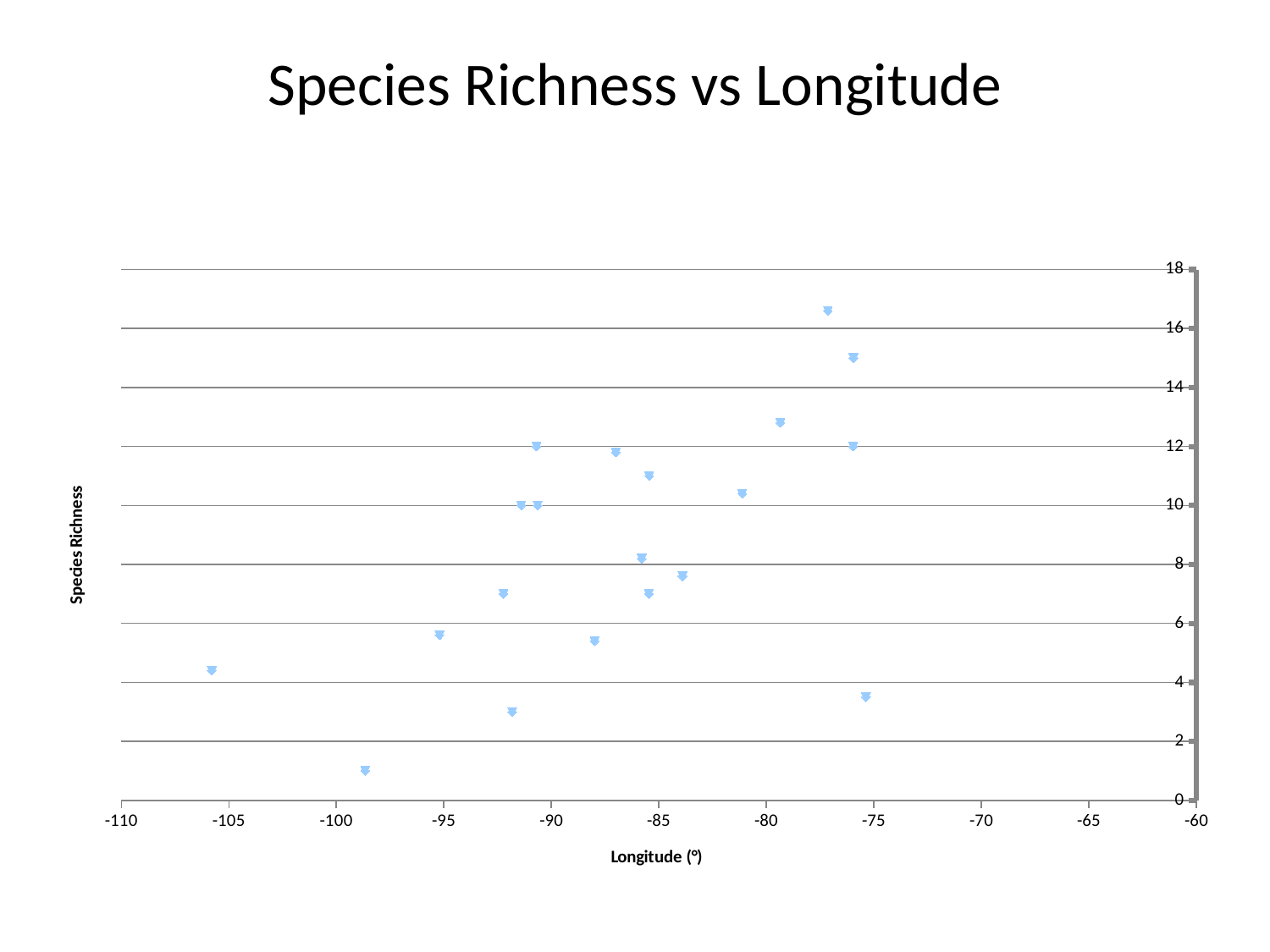
Is the species richness of the highest point on the chart greater or less than 16? greater Is the species richness of the point near longitude -77 greater or less than 16? greater What is the maximum value shown on the species richness axis? 18 Is the species richness of the lowest point on the chart greater or less than 2? less What is the title of the chart? Species Richness vs Longitude Overall, does species richness tend to rise or fall as longitude increases from -110 toward -60? rise How many data points are plotted on the chart? 20 What kind of chart is shown on the slide? scatter plot What is the label of the x axis? Longitude (°)